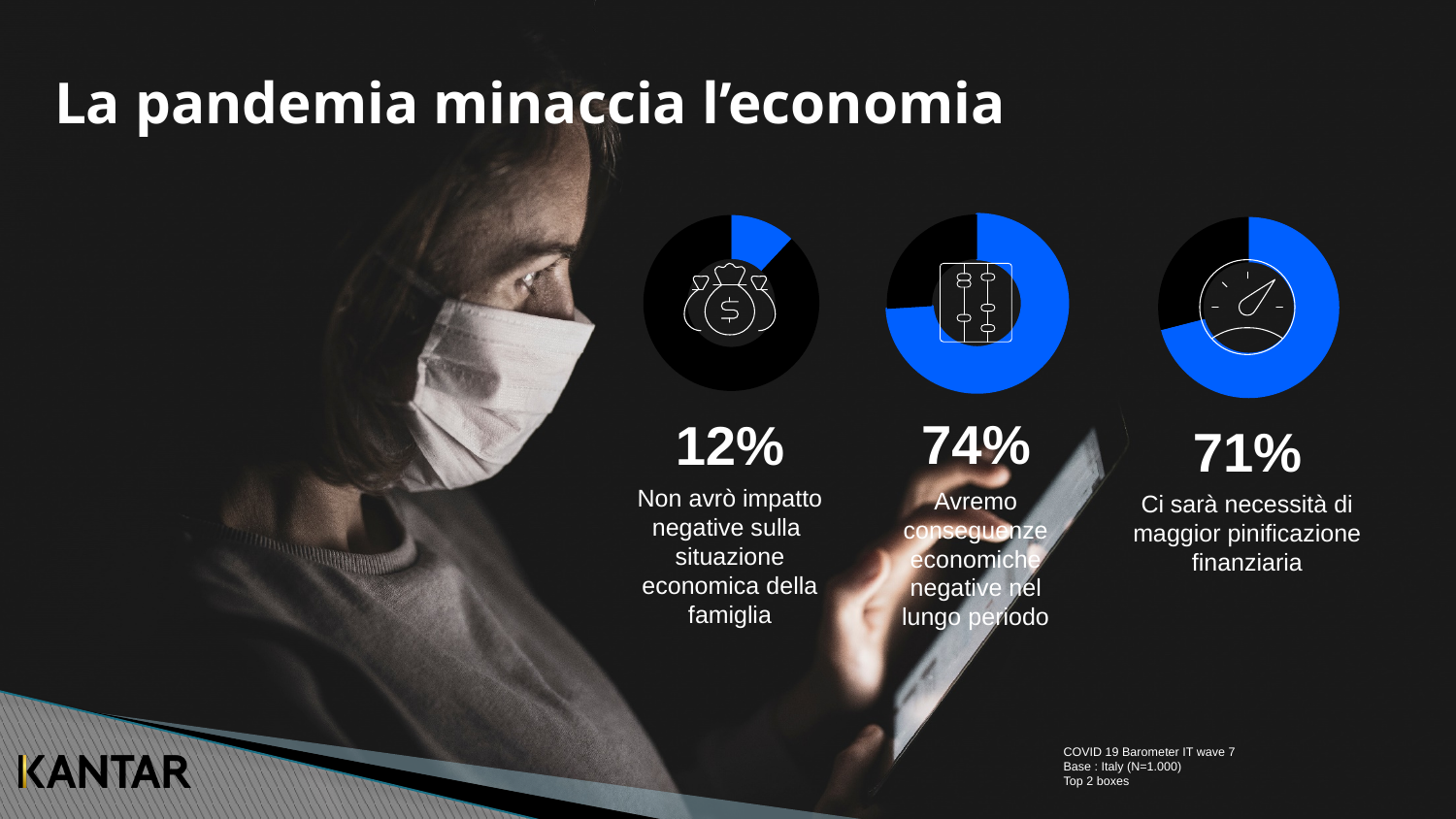
How many donut charts are on the slide? 3 Which of the three donut charts shows the highest percentage? Avremo conseguenze economiche negative nel lungo periodo (74%) What percentage is shown for the left donut chart, labelled 'Non avrò impatto negative sulla situazione economica della famiglia'? 12% What is the difference between the middle chart's value (74%) and the left chart's value (12%)? 62 percentage points What kind of charts are shown on the slide? Donut (pie) charts What percentage is shown for the right donut chart, labelled 'Ci sarà necessità di maggior pinificazione finanziaria'? 71% Which is larger: the percentage for 'Avremo conseguenze economiche negative nel lungo periodo' or for 'Ci sarà necessità di maggior pinificazione finanziaria'? Avremo conseguenze economiche negative nel lungo periodo (74%) Which of the three donut charts shows the lowest percentage? Non avrò impatto negative sulla situazione economica della famiglia (12%) What is the difference between the middle chart's value (74%) and the right chart's value (71%)? 3 percentage points What percentage is shown for the middle donut chart, labelled 'Avremo conseguenze economiche negative nel lungo periodo'? 74% What colour is used for the highlighted (filled) portion of each donut chart? Blue What is the title of the slide? La pandemia minaccia l'economia